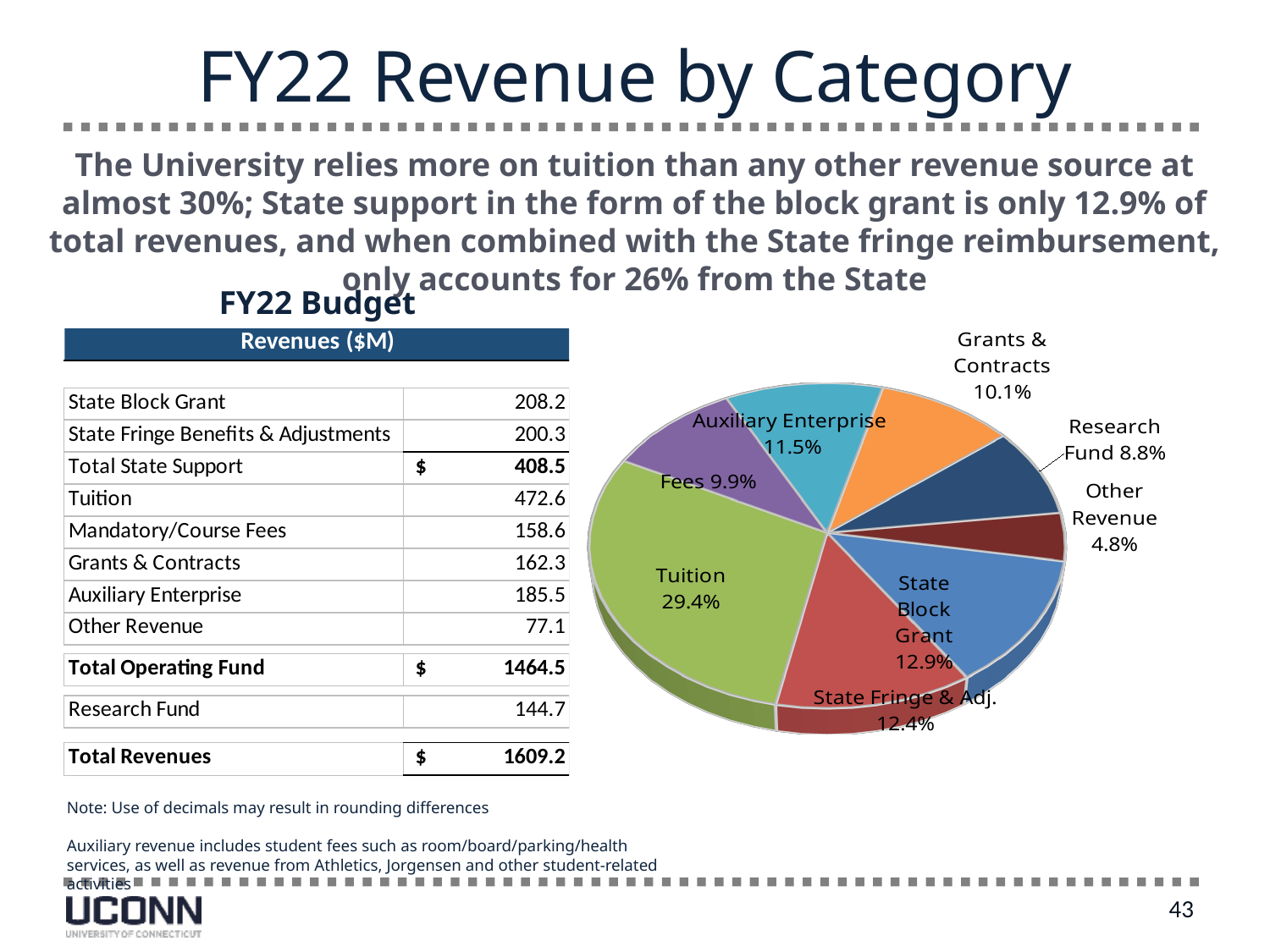
What is the difference in percentage points between Tuition and State Block Grant in the pie chart? 16.5 How many slices does the pie chart have? 8 Which category has the largest slice of the pie? Tuition What percentage is shown for the State Block Grant slice? 12.9% What kind of chart is shown on the slide? pie chart Which category has the smallest slice of the pie? Other Revenue What is the difference in percentage points between State Block Grant and State Fringe & Adj. in the pie chart? 0.5 What share of the pie does Tuition account for? 29.4% What colour is the Tuition slice in the pie chart? green What percentage is shown for Research Fund in the pie chart? 8.8% What percentage is shown for Auxiliary Enterprise in the pie chart? 11.5% Which slice is larger, Grants & Contracts or Fees? Grants & Contracts